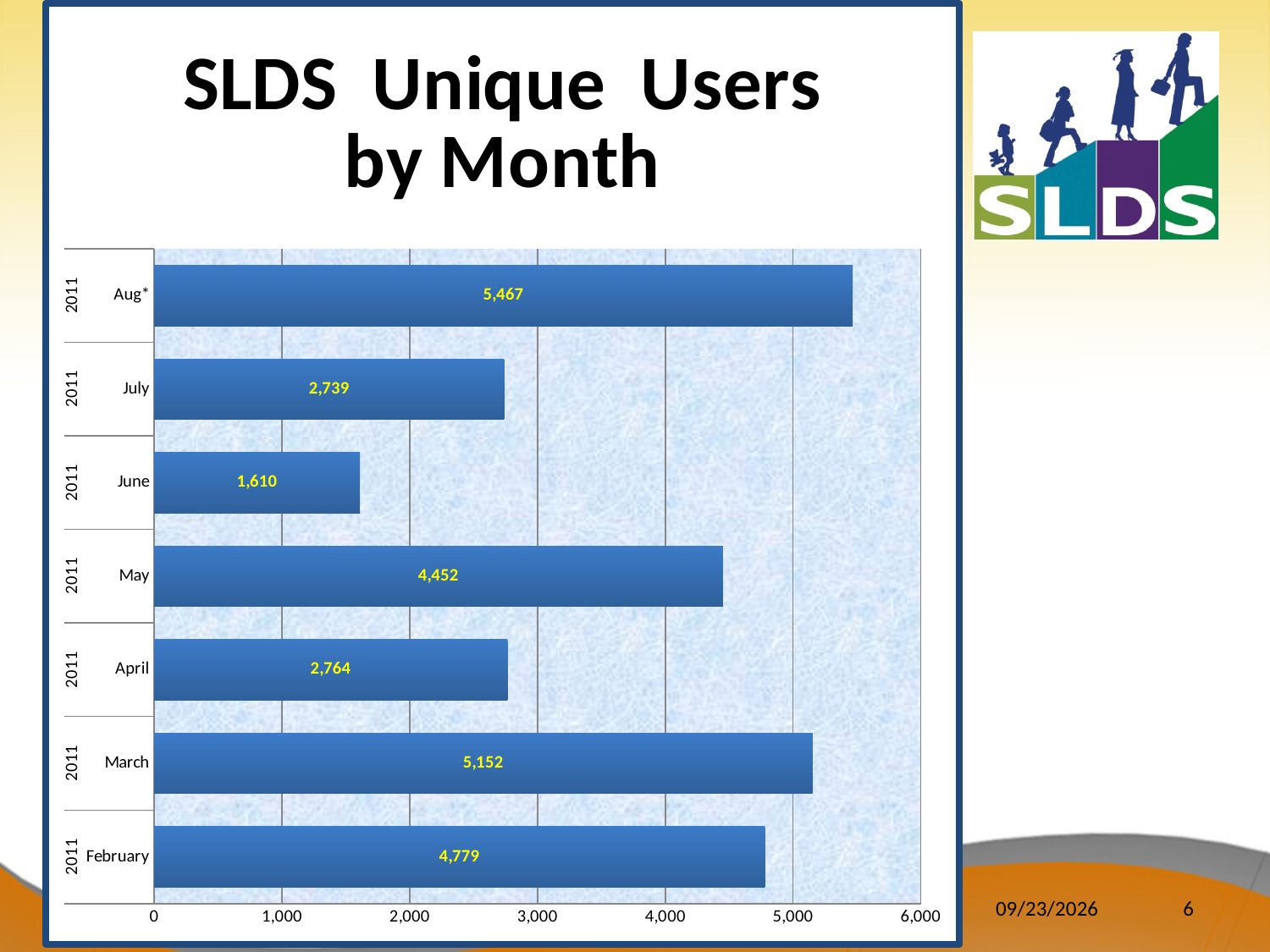
What is the title of the slide? SLDS Unique Users by Month Which month has the lowest number of unique users? June What kind of chart is shown on the slide? Bar chart What is the difference in unique users between Aug* and July? 2,728 What is the difference in unique users between March and February? 373 How many months are shown in the chart? 7 Which has more unique users, April or July? April Is the value for May greater or less than 4,000? greater What is the number of unique users for May 2011? 4,452 What is the number of unique users for June 2011? 1,610 What is the number of unique users for February 2011? 4,779 Which month has the highest number of unique users? Aug*